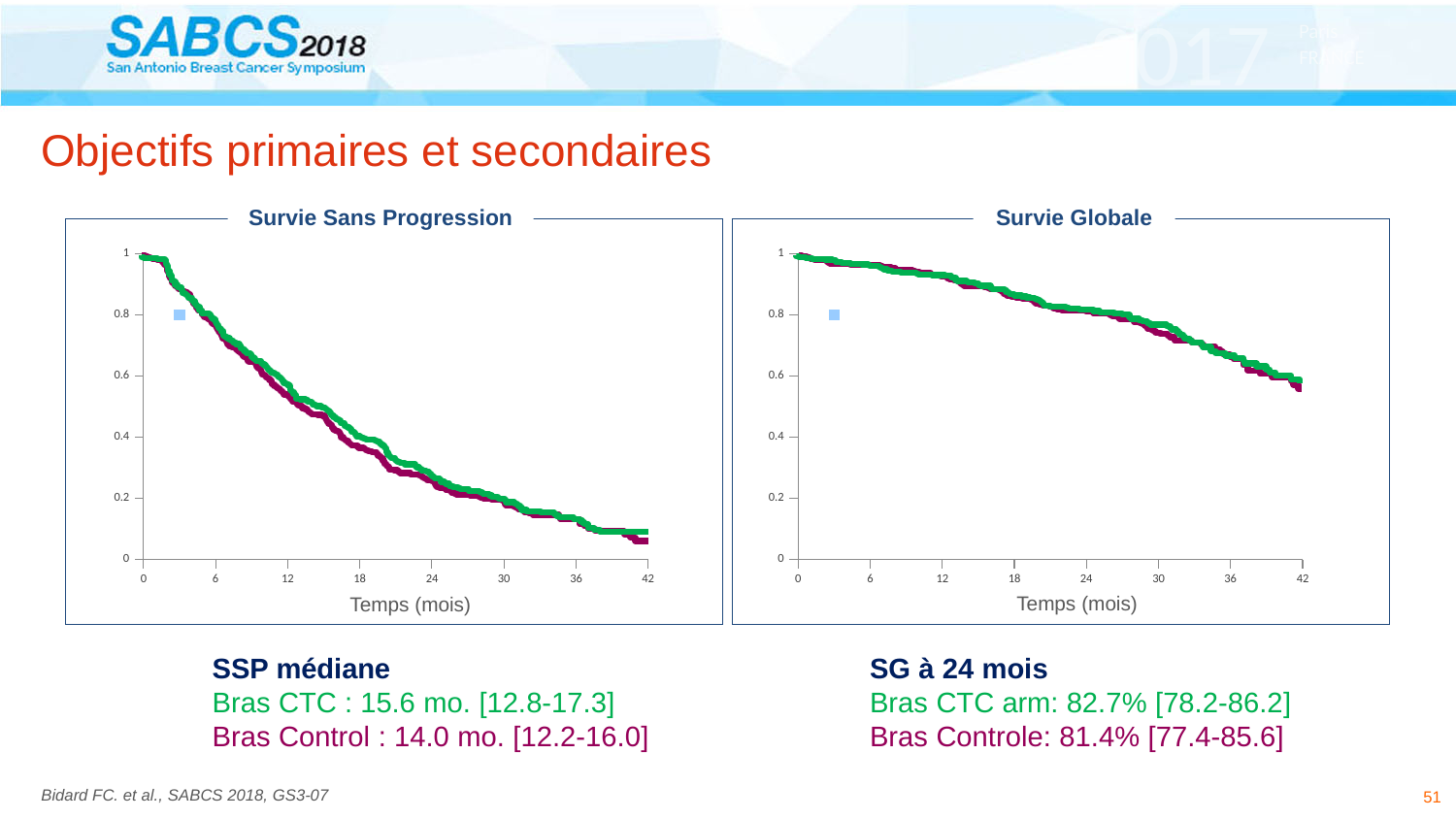
In the 'Survie Globale' chart, is the value of the green curve at 12 months greater or less than 0.8? greater In the 'Survie Sans Progression' chart, is the value of the green curve at 12 months greater or less than 0.4? greater What is the x-axis label of the 'Survie Sans Progression' chart? Temps (mois) What is the highest tick value shown on the x axis of the 'Survie Globale' chart? 42 What kind of chart is the 'Survie Globale' chart? line chart In the 'Survie Globale' chart, do the curves rise or fall as time increases along the x axis? fall How many curves are plotted in the 'Survie Globale' chart? 2 In the 'Survie Sans Progression' chart, is the value of the curves at 42 months greater or less than 0.2? less In the 'Survie Sans Progression' chart, do the curves rise or fall as time increases along the x axis? fall What kind of chart is the 'Survie Sans Progression' chart? line chart